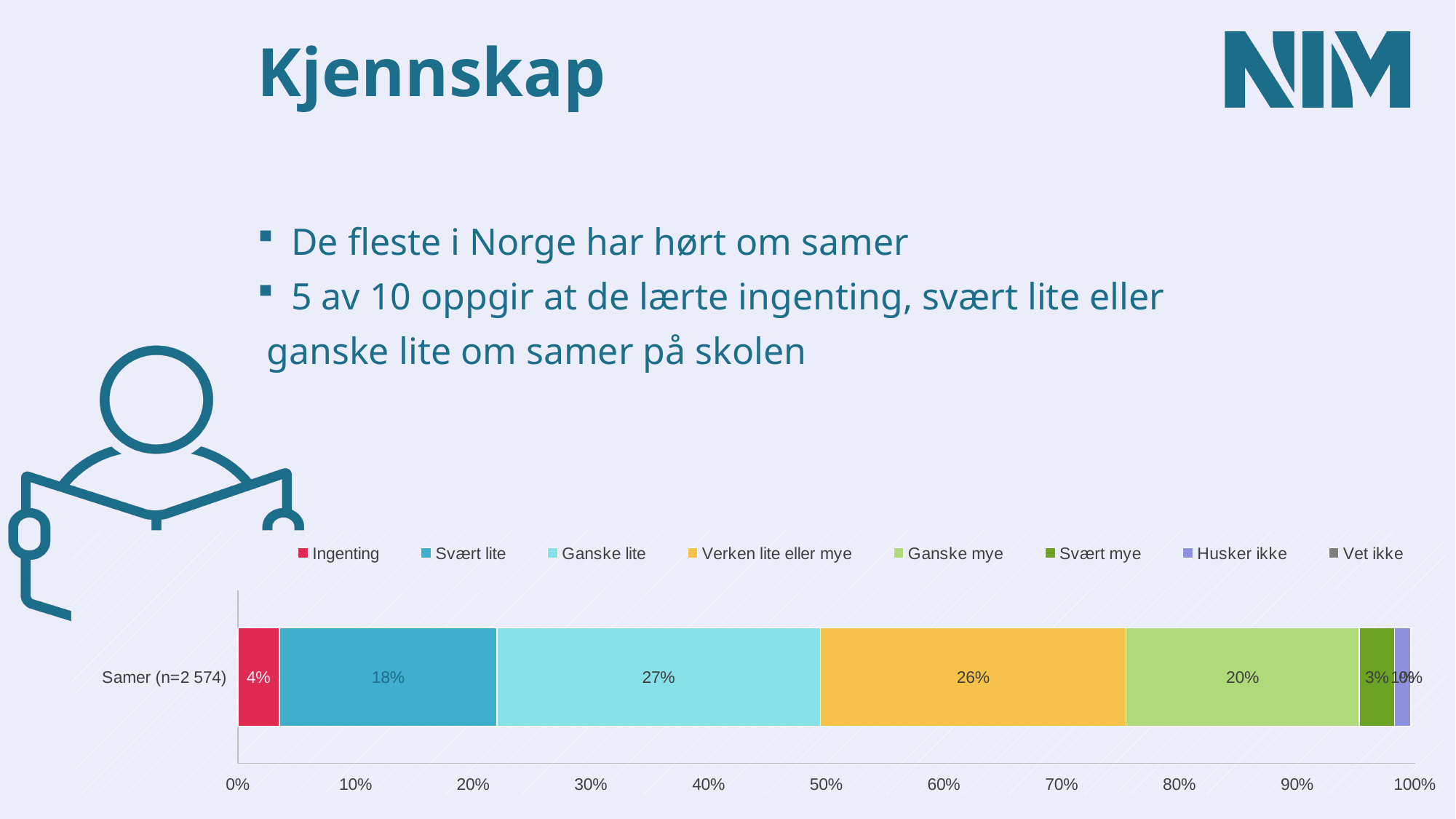
What percentage of the bar is labelled for the "Ingenting" series? 4% Which is larger, the value for "Ganske mye" or the value for "Svært lite"? Ganske mye What value is shown for "Ganske lite"? 27% What is the label of the single category shown on the vertical axis? Samer (n=2 574) What kind of chart is shown on the slide? Stacked bar chart How many series does the legend list? 8 What value is shown for "Ganske mye"? 20% What value is shown for "Verken lite eller mye"? 26% What value is shown for "Svært lite" in the stacked bar? 18% What value is shown for "Svært mye"? 3% Which series has the largest labelled share of the bar? Ganske lite What is the difference between the values for "Ganske lite" and "Verken lite eller mye"? 1%